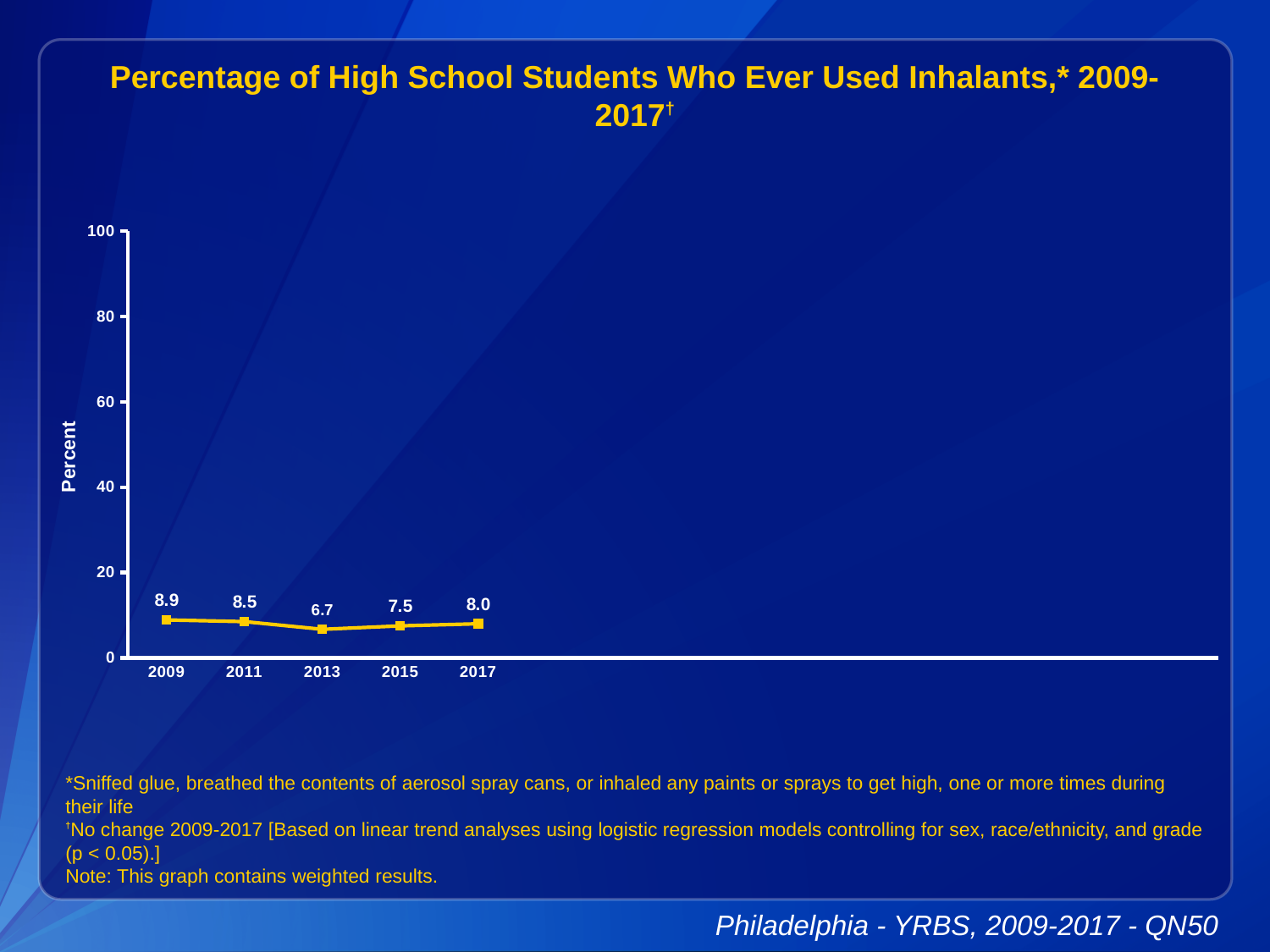
What percentage of high school students had ever used inhalants in 2009? 8.9 Which year has the highest percentage of students who ever used inhalants? 2009 What is the label on the y axis? Percent Which year has the lowest percentage of students who ever used inhalants? 2013 How many years are plotted on the chart? 5 What is the difference between the 2009 value and the 2013 value? 2.2 Which year has a larger value, 2011 or 2015? 2011 What is the value plotted for 2013? 6.7 What kind of chart is shown on the slide? line chart Is the value for 2015 greater or less than 20? less What is the value plotted for 2017? 8.0 Does the value rise or fall from 2013 to 2017? rise